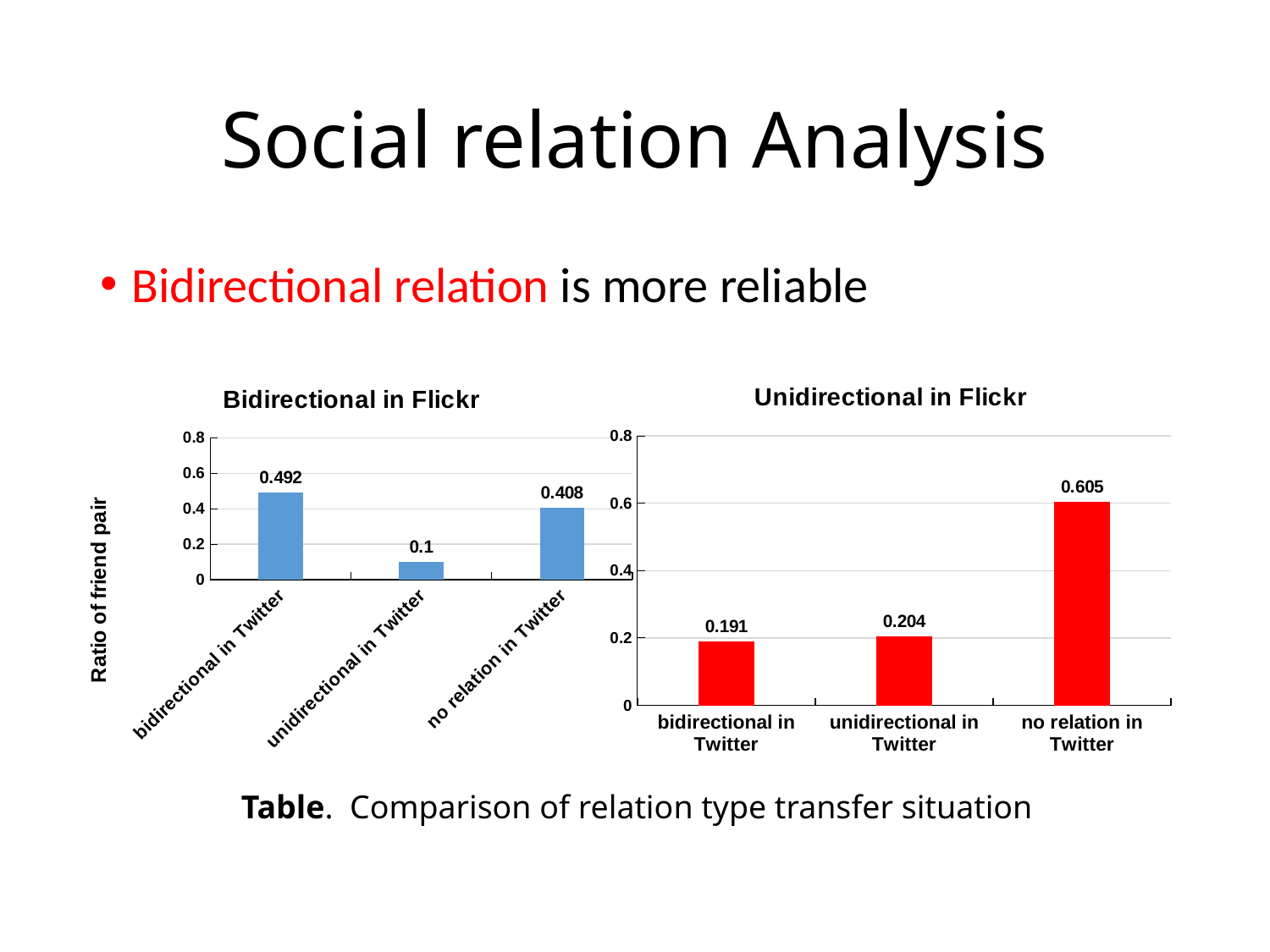
In the 'Bidirectional in Flickr' chart, what is the value for 'unidirectional in Twitter'? 0.1 In the 'Unidirectional in Flickr' chart, which category has the lowest value? bidirectional in Twitter In the 'Bidirectional in Flickr' chart, what is the value for 'bidirectional in Twitter'? 0.492 In the 'Unidirectional in Flickr' chart, what is the value for 'bidirectional in Twitter'? 0.191 In the 'Bidirectional in Flickr' chart, which is larger: the value for 'unidirectional in Twitter' or 'no relation in Twitter'? no relation in Twitter In the 'Unidirectional in Flickr' chart, what is the value for 'no relation in Twitter'? 0.605 What kind of chart is the 'Bidirectional in Flickr' chart? bar chart In the 'Unidirectional in Flickr' chart, what is the difference between the values for 'no relation in Twitter' and 'unidirectional in Twitter'? 0.401 In the 'Bidirectional in Flickr' chart, what is the difference between the values for 'bidirectional in Twitter' and 'no relation in Twitter'? 0.084 How many categories are shown in the 'Unidirectional in Flickr' chart? 3 What is the y-axis label of the 'Bidirectional in Flickr' chart? Ratio of friend pair In the 'Bidirectional in Flickr' chart, which category has the highest value? bidirectional in Twitter